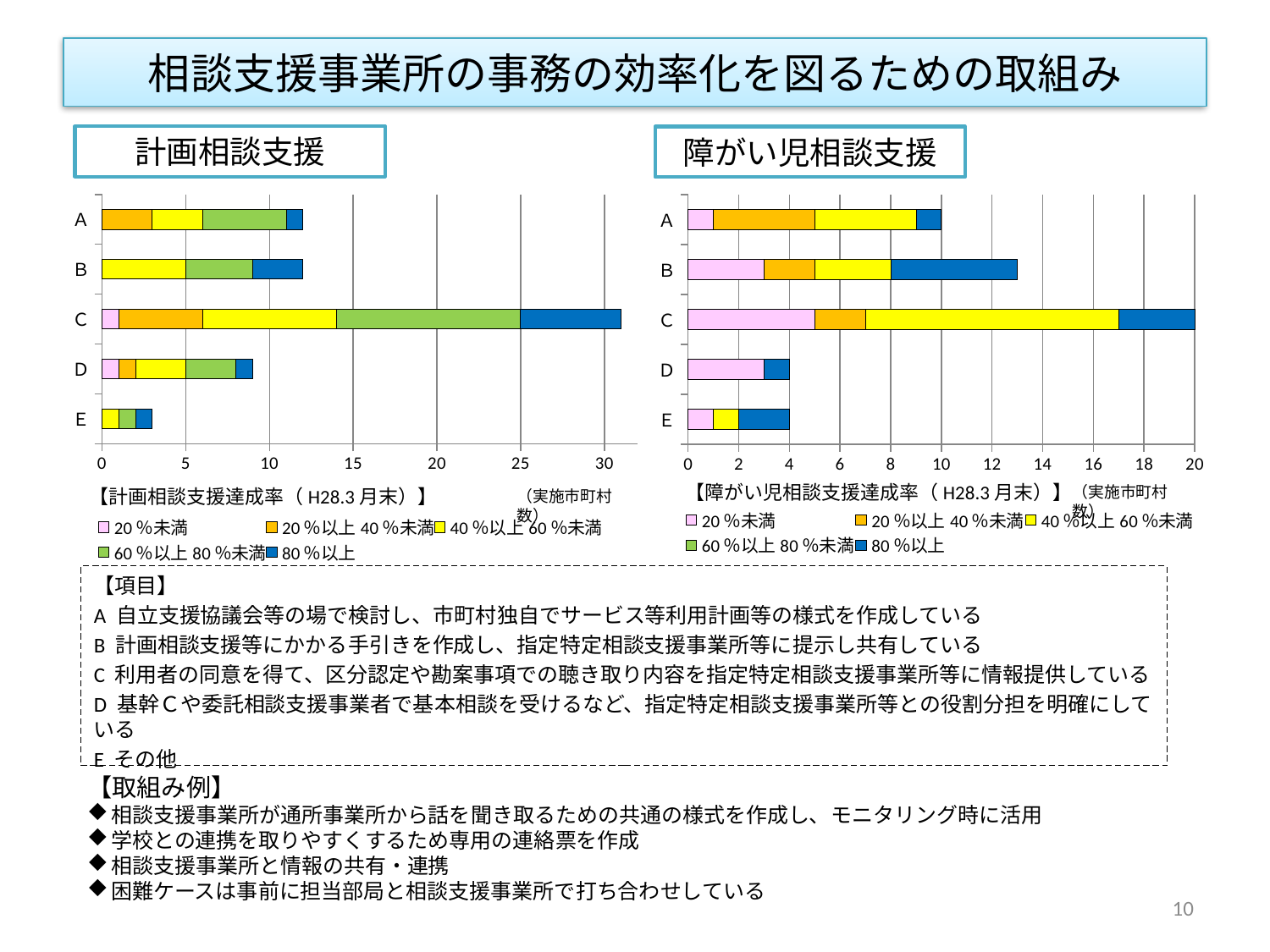
In the 障がい児相談支援 chart on the right, which total bar is longer, A or B? B What kind of chart is the 計画相談支援 chart on the left? bar chart In the 障がい児相談支援 chart on the right, is the total bar for D greater or less than 6? less In the 計画相談支援 chart on the left, is the total bar for E greater or less than 5? less In the 障がい児相談支援 chart on the right, is the total bar for B greater or less than 10? greater In the 計画相談支援 chart on the left, which category has the longest total bar? C How many categories are shown on the y axis of the 計画相談支援 chart on the left? 5 In the 計画相談支援 chart on the left, which category has the shortest total bar? E In the 障がい児相談支援 chart on the right, which category has the longest total bar? C In the 計画相談支援 chart on the left, which total bar is longer, A or D? A How many series does the legend of the 障がい児相談支援 chart on the right list? 5